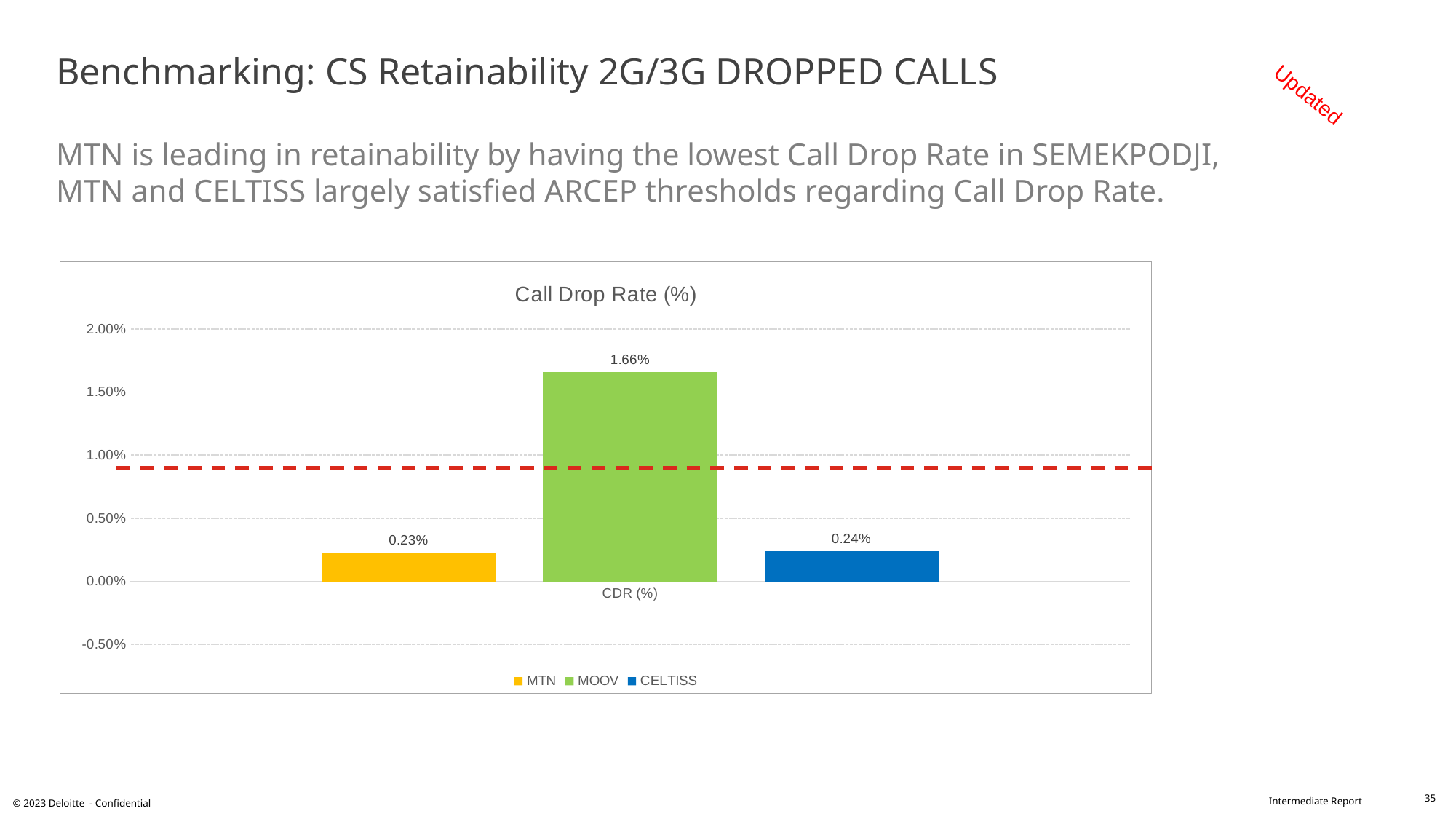
Which operator has the highest Call Drop Rate? MOOV How many series does the legend list? 3 Is the Call Drop Rate for MOOV greater or less than 1.50%? greater What is the difference between the Call Drop Rate of MOOV and MTN? 1.43% Which operator has the lowest Call Drop Rate according to the data labels? MTN What is the Call Drop Rate for MTN? 0.23% What is the Call Drop Rate for CELTISS? 0.24% What kind of chart is shown on the slide? Bar chart What is the title of the chart? Call Drop Rate (%) Which has a larger Call Drop Rate, MOOV or CELTISS? MOOV What is the difference between the Call Drop Rate of CELTISS and MTN? 0.01% What is the Call Drop Rate for MOOV? 1.66%